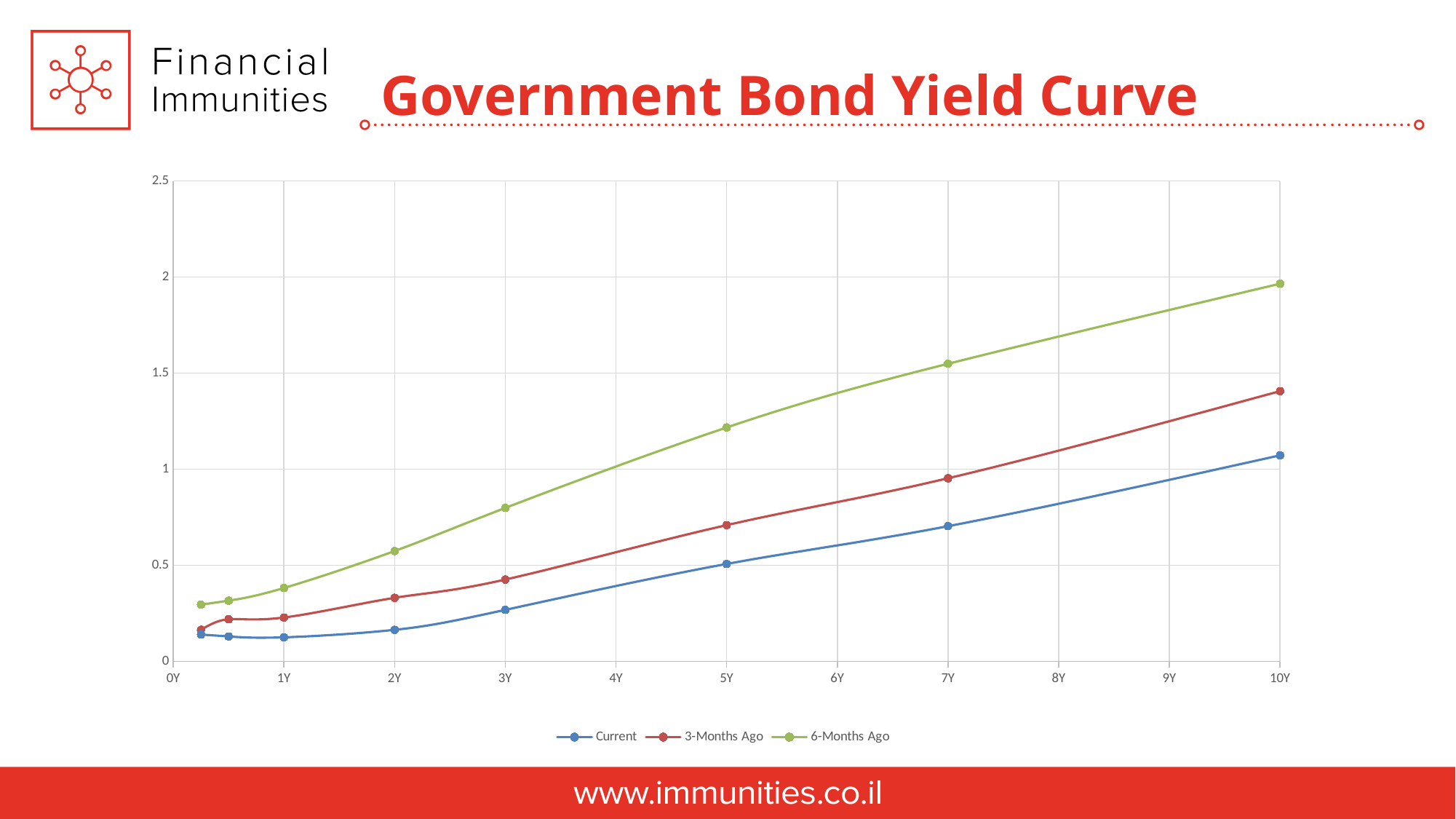
Do the values of the Current series rise or fall from 2Y to 10Y? rise Which series has the lowest value at 10Y? Current Which series is plotted in blue? Current How many series does the legend list? 3 What is the title of the chart? Government Bond Yield Curve What kind of chart is shown on the slide? line chart At 10Y, is the value for 6-Months Ago greater or less than 1.5? greater At 3Y, is the value for 3-Months Ago greater or less than 0.5? less Which series has the highest value at 10Y? 6-Months Ago At 5Y, is the value for 6-Months Ago greater or less than 1? greater At 7Y, which is larger: the Current value or the 3-Months Ago value? 3-Months Ago